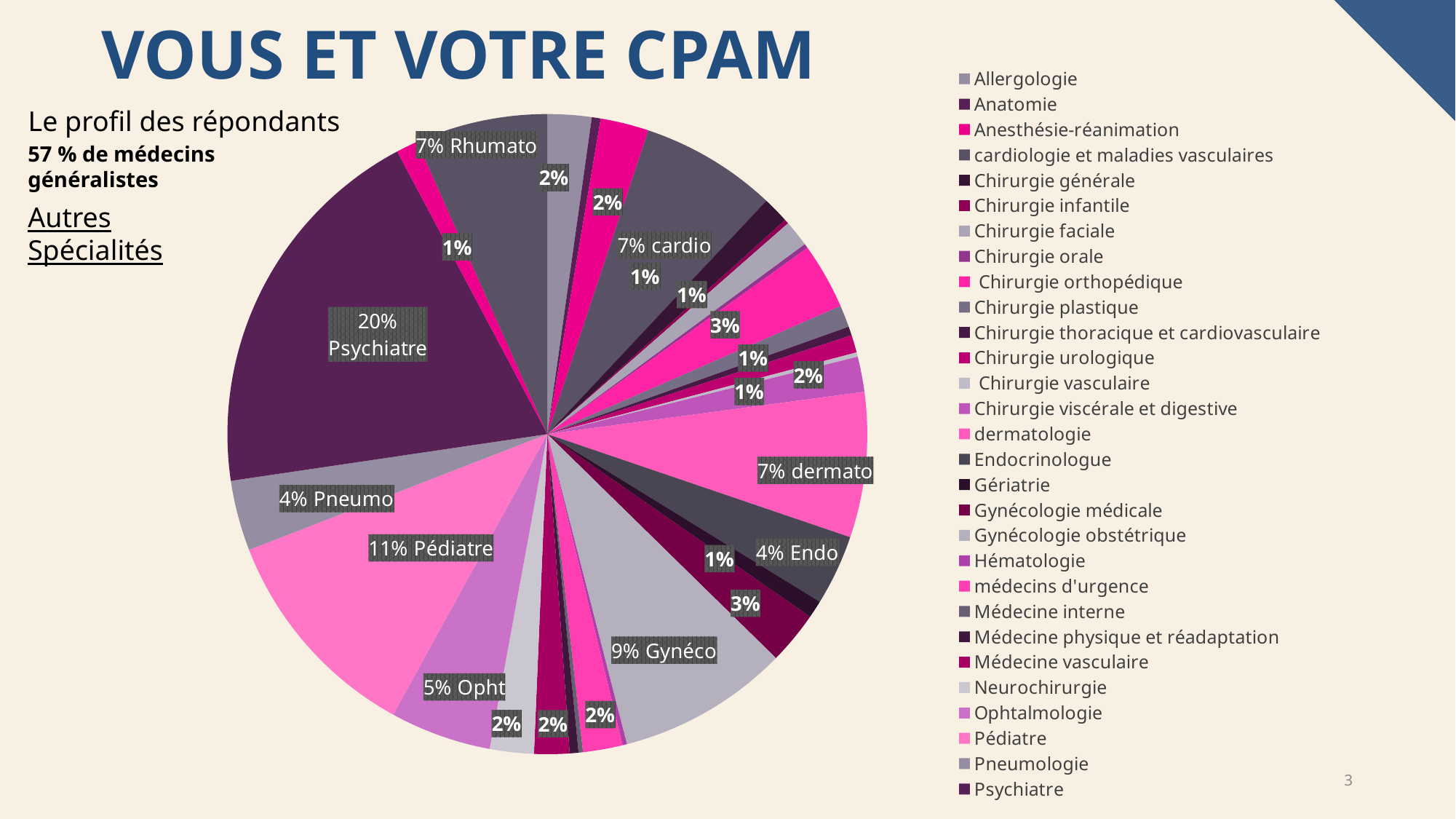
What is the value shown for Gynéco? 9% What is the difference in percentage points between Psychiatre and Pédiatre? 9 Which is larger, the Pédiatre slice or the Gynéco slice? Pédiatre What is the value shown for Pneumo? 4% What is the value shown for Opht? 5% What share of the pie does the Psychiatre slice represent? 20% What is the value shown for Endo? 4% What kind of chart is shown on the slide? Pie chart Which labelled specialty has the largest slice of the pie? Psychiatre What is the value shown for Rhumato? 7% What is the value shown for Pédiatre? 11% What is the title at the top of the slide? VOUS ET VOTRE CPAM